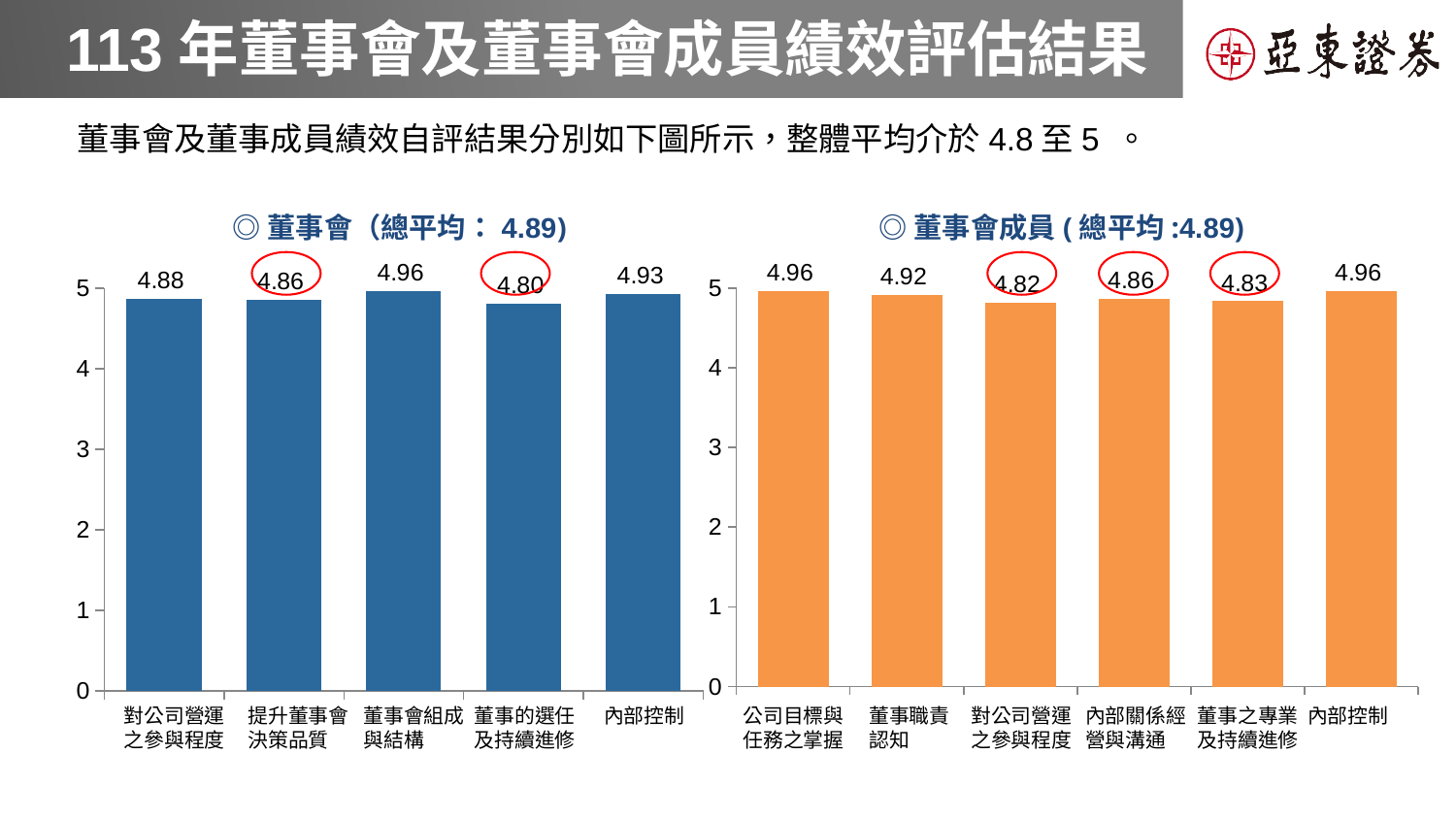
In the 董事會成員 chart on the right, which is larger: 董事職責認知 or 董事之專業及持續進修? 董事職責認知 In the 董事會 chart on the left, what is the difference between 內部控制 and 提升董事會決策品質? 0.07 In the 董事會 chart on the left, what is the value for 董事的選任及持續進修? 4.80 How many categories are shown in the 董事會 chart on the left? 5 In the 董事會 chart on the left, which category has the lowest value? 董事的選任及持續進修 In the 董事會成員 chart on the right, what is the value for 董事職責認知? 4.92 How many categories are shown in the 董事會成員 chart on the right? 6 In the 董事會 chart on the left, which category has the highest value? 董事會組成與結構 In the 董事會成員 chart on the right, what is the value for 內部關係經營與溝通? 4.86 In the 董事會成員 chart on the right, which category has the lowest value? 對公司營運之參與程度 In the 董事會 chart on the left, what is the value for 董事會組成與結構? 4.96 What type of chart is the 董事會成員 chart on the right? bar chart